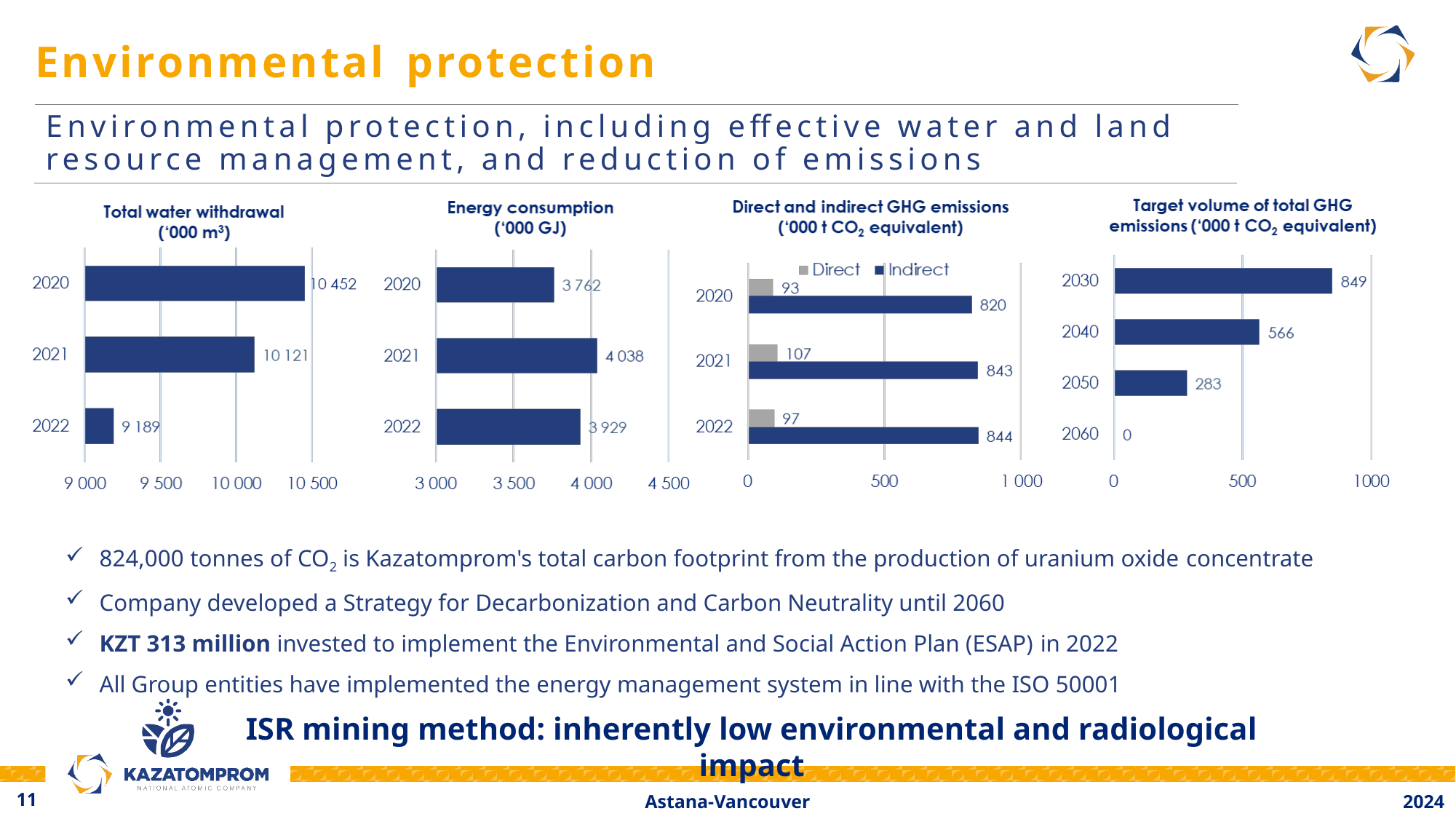
In the 'Direct and indirect GHG emissions' chart, what is the total of Direct and Indirect emissions for 2020? 913 In the 'Total water withdrawal' chart, what is the value for 2022? 9 189 In the 'Total water withdrawal' chart, what is the difference between the 2020 and 2021 values? 331 In the 'Energy consumption' chart, is the value for 2022 greater or less than 4 000? less In the 'Direct and indirect GHG emissions' chart, what is the Direct value for 2021? 107 In the 'Target volume of total GHG emissions' chart, do the values rise or fall from 2030 to 2060? fall In the 'Direct and indirect GHG emissions' chart, how many series does the legend list? 2 In the 'Total water withdrawal' chart, which year has the highest value? 2020 In the 'Energy consumption' chart, what is the value for 2021? 4 038 In the 'Target volume of total GHG emissions' chart, what is the value for 2050? 283 In the 'Energy consumption' chart, which year has the lowest value? 2020 What kind of chart is the 'Target volume of total GHG emissions' chart? bar chart